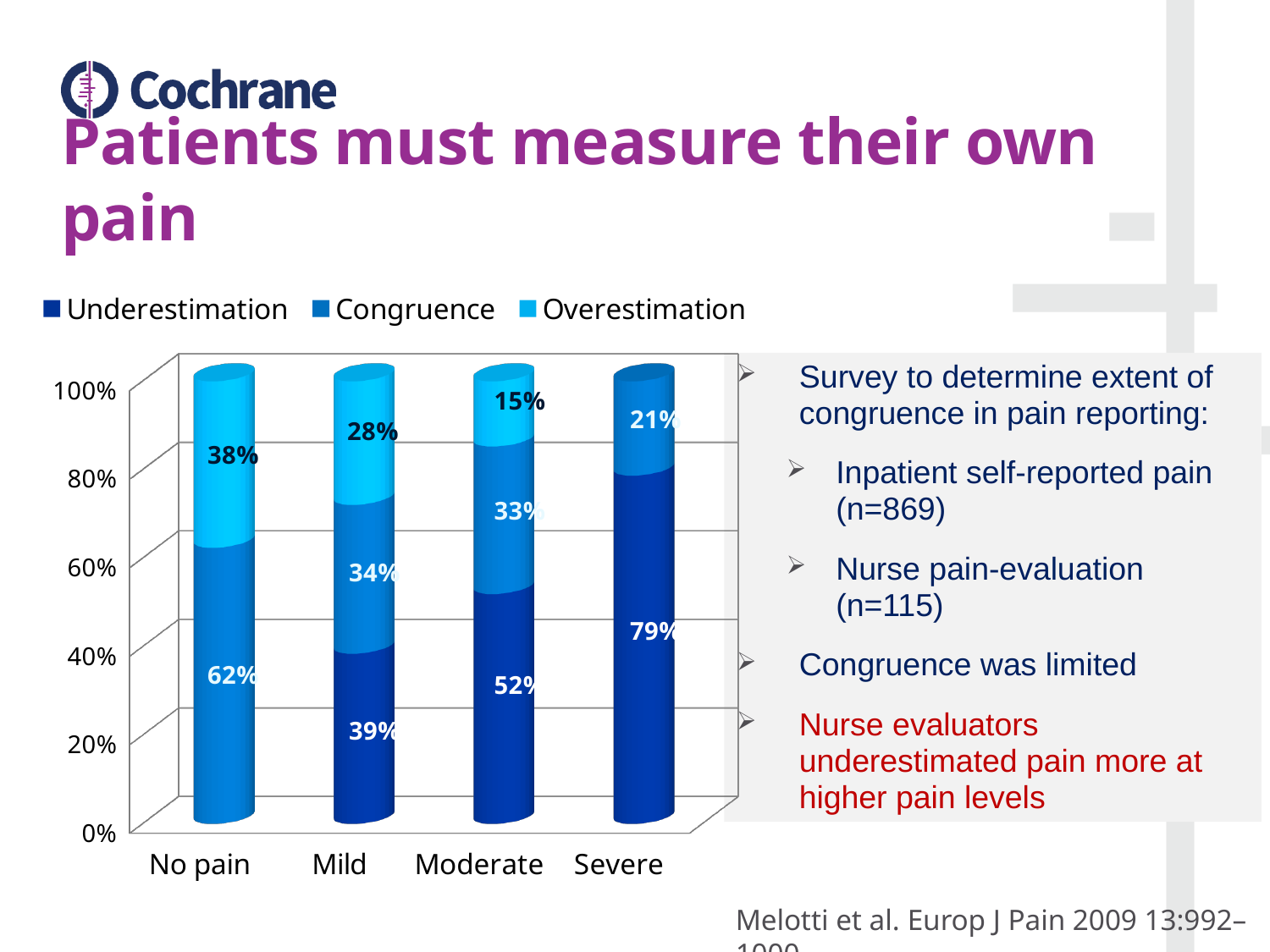
What is the Underestimation value for the Severe category? 79% Does the Underestimation value rise or fall from Mild to Severe? Rise Which category has the larger Congruence value, No pain or Moderate? No pain Which category has the highest Underestimation value? Severe Which category has the highest Overestimation value? No pain What is the Underestimation value for the Moderate category? 52% How many series does the legend list? 3 How many pain categories are shown on the x axis? 4 What is the difference between the Underestimation values for Severe and Mild? 40 percentage points What is the Congruence value for the Mild category? 34% What is the Overestimation value for the No pain category? 38% What kind of chart is shown on the slide? Stacked bar chart